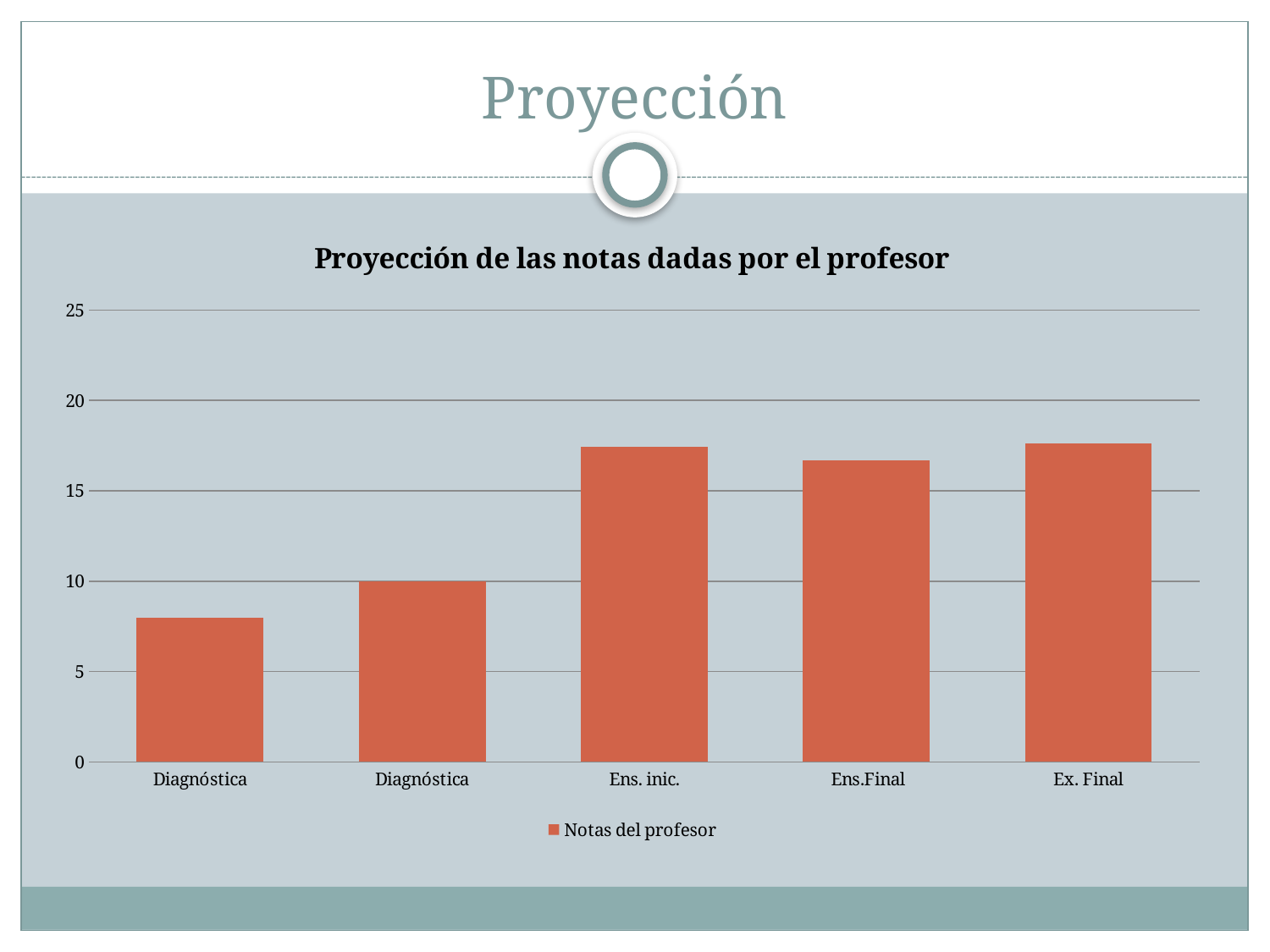
Is the value for Ens. inic. greater or less than 15? greater How many series does the legend list? 1 Is the value for Ens.Final greater or less than 15? greater How many bars are plotted in the chart? 5 What is the value of the second Diagnóstica bar? 10 Is the value for Ex. Final greater or less than 20? less Which is larger, the value for Ens. inic. or the value for the second Diagnóstica bar? Ens. inic. What type of chart is shown on the slide? Bar chart What series does the legend list? Notas del profesor Which bar has the lowest value? Diagnóstica (the first bar) What is the title of the chart? Proyección de las notas dadas por el profesor